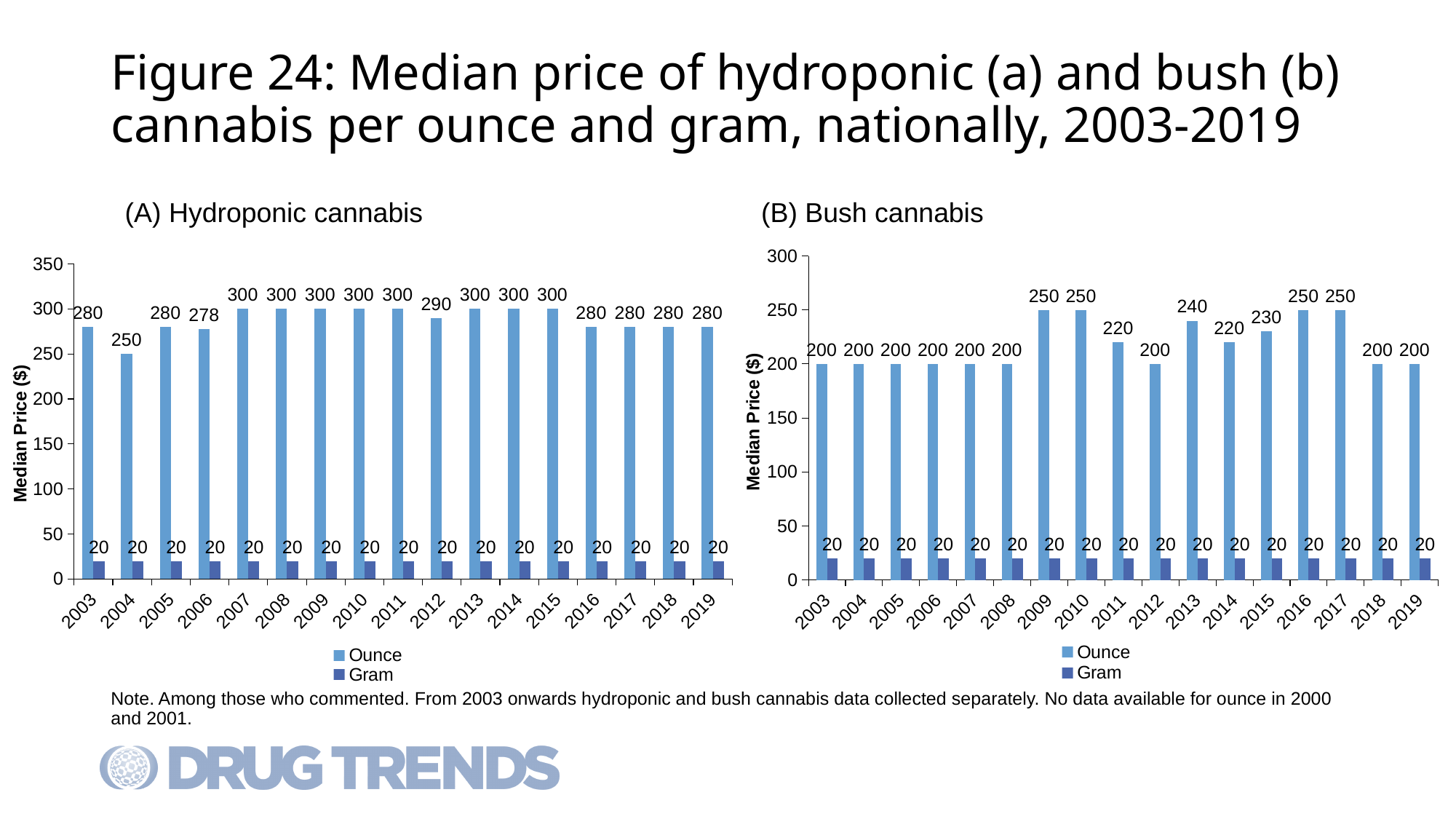
In the (A) Hydroponic cannabis chart, what is the median price per ounce in 2004? 250 In the (A) Hydroponic cannabis chart, what is the median price per ounce in 2006? 278 In the (B) Bush cannabis chart, what is the highest median price per ounce shown? 250 In the (A) Hydroponic cannabis chart, which year has the lowest median price per ounce? 2004 In the (B) Bush cannabis chart, is the median ounce price higher in 2015 or in 2014? 2015 What type of chart is the (A) Hydroponic cannabis chart? Bar chart In the (B) Bush cannabis chart, what is the difference between the median ounce price in 2009 and in 2008? 50 In the (A) Hydroponic cannabis chart, what is the difference between the median ounce price in 2007 and in 2004? 50 In the (B) Bush cannabis chart, what is the median price per gram in 2019? 20 How many series does the legend of the (B) Bush cannabis chart list? 2 In the (B) Bush cannabis chart, what is the median price per ounce in 2013? 240 How many years are shown on the x axis of the (A) Hydroponic cannabis chart? 17